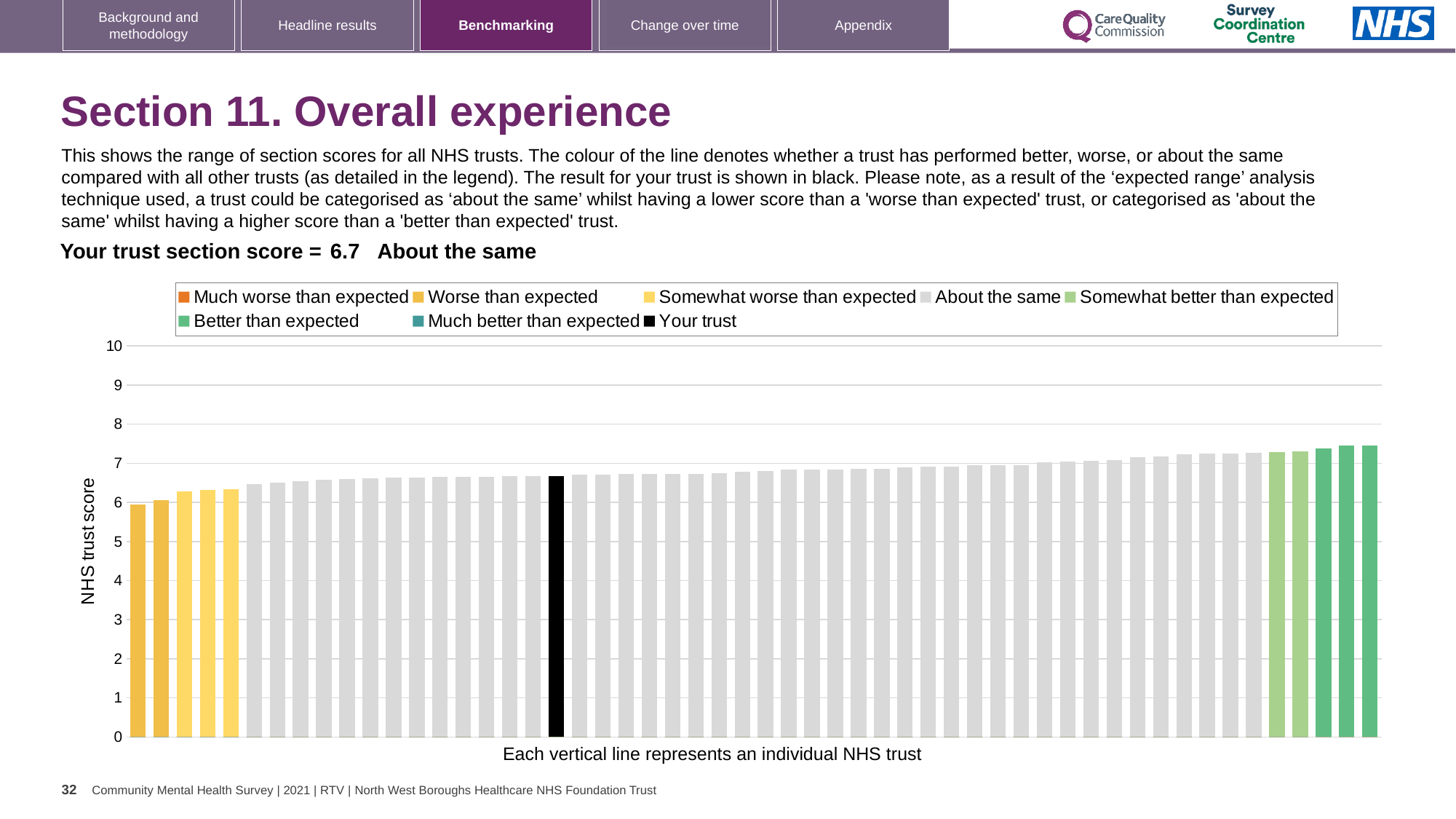
Is the value of the shortest bar on the chart greater or less than 5? greater What is the section score for your trust shown on the slide? 6.7 Which is larger: the black 'Your trust' bar or the leftmost bar on the chart? Your trust What is the label on the vertical axis of the chart? NHS trust score Do the bar values rise or fall from left to right along the x axis? rise What colour is the bar representing your trust? black Is the value of the tallest bar on the chart greater or less than 7? greater What kind of chart is shown on the slide? bar chart Is the value of the black 'Your trust' bar greater or less than 6? greater How many entries does the chart legend list? 8 How many bars are coloured as 'Worse than expected' (dark yellow)? 2